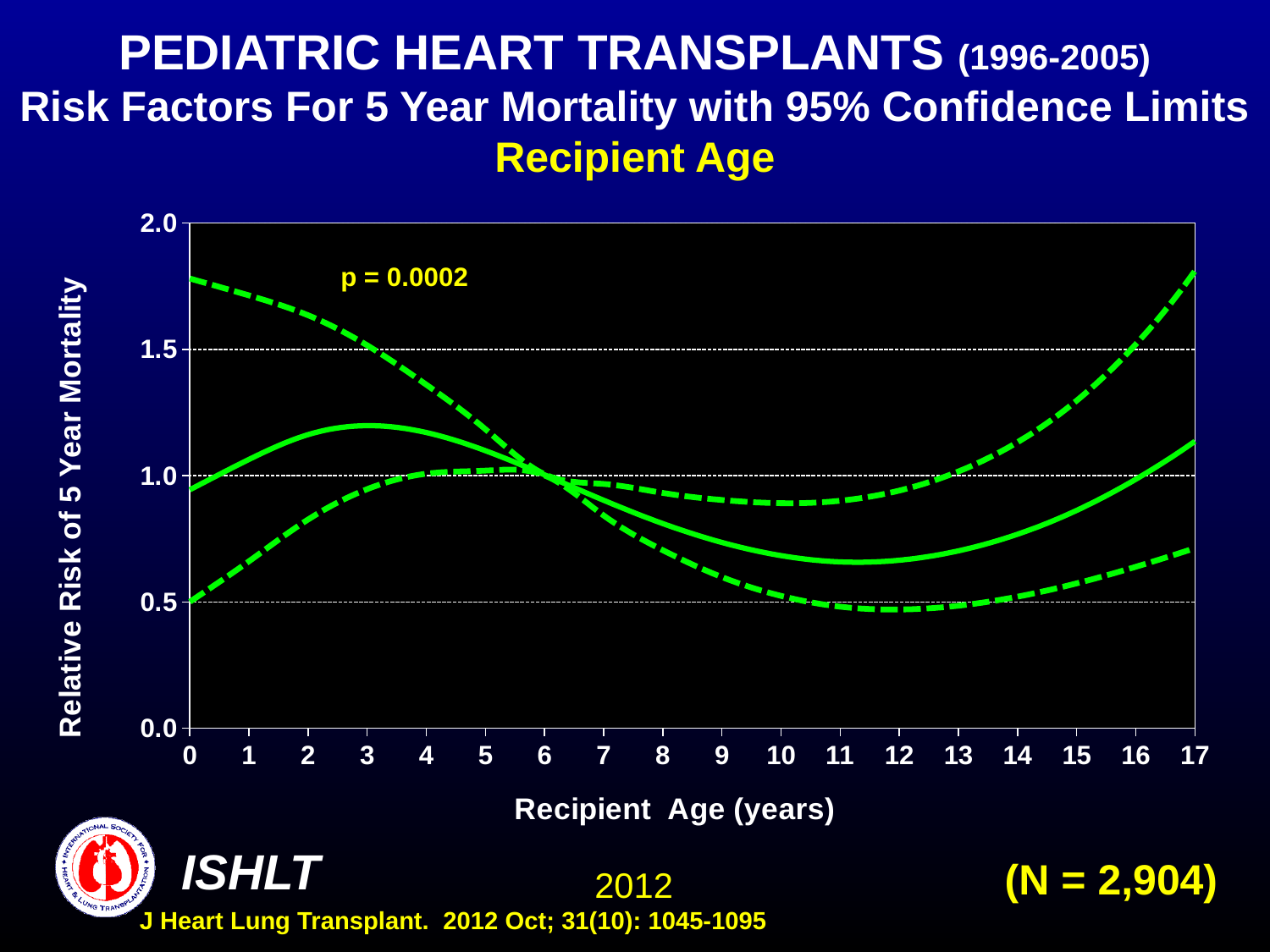
Is the value of the upper dashed confidence limit at recipient age 10 greater or less than 1.0? less What is the label of the y-axis? Relative Risk of 5 Year Mortality Is the value of the upper dashed confidence limit at recipient age 17 greater or less than 1.5? greater What kind of chart is shown on the slide? line chart What is the p-value printed on the chart? p = 0.0002 Does the solid line rise or fall between recipient age 12 and recipient age 17? rise Is the value of the solid line at recipient age 11 greater or less than 1.0? less Does the solid line rise or fall between recipient age 3 and recipient age 11? fall How many lines are plotted on the chart? 3 What is the highest value shown on the y-axis? 2.0